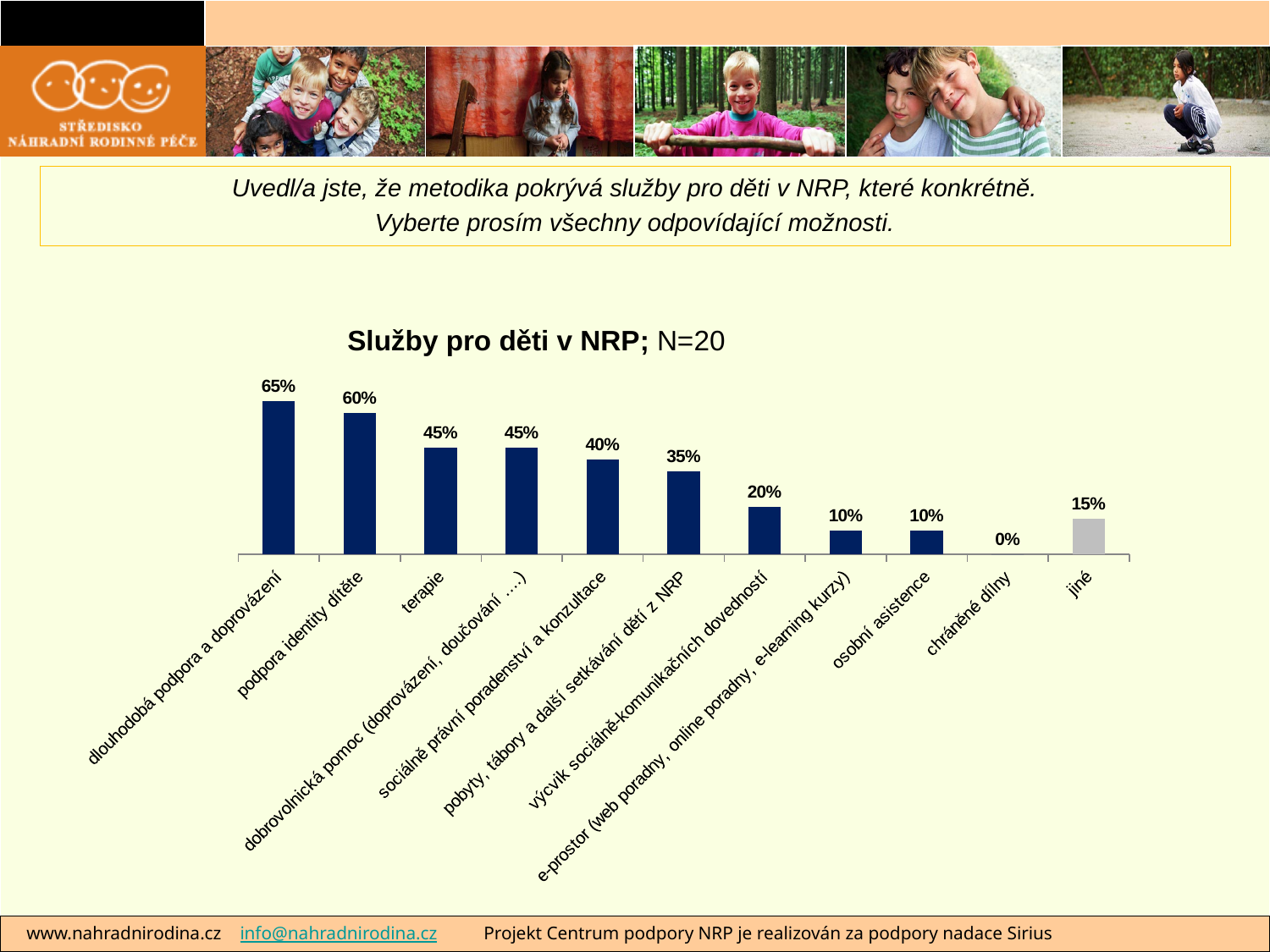
What is the value for 'dlouhodobá podpora a doprovázení'? 65% How many categories are shown in the chart? 11 What is the value for 'terapie'? 45% What is the title of the chart? Služby pro děti v NRP; N=20 Which category has the lowest value? chráněné dílny What is the value for 'osobní asistence'? 10% Which category has the highest value? dlouhodobá podpora a doprovázení What is the value for 'jiné'? 15% What is the sample size (N) stated in the chart title? 20 What kind of chart is shown on the slide? bar chart Which is larger, 'pobyty, tábory a další setkávání dětí z NRP' or 'výcvik sociálně-komunikačních dovedností'? pobyty, tábory a další setkávání dětí z NRP What is the difference between 'podpora identity dítěte' and 'sociálně právní poradenství a konzultace'? 20%